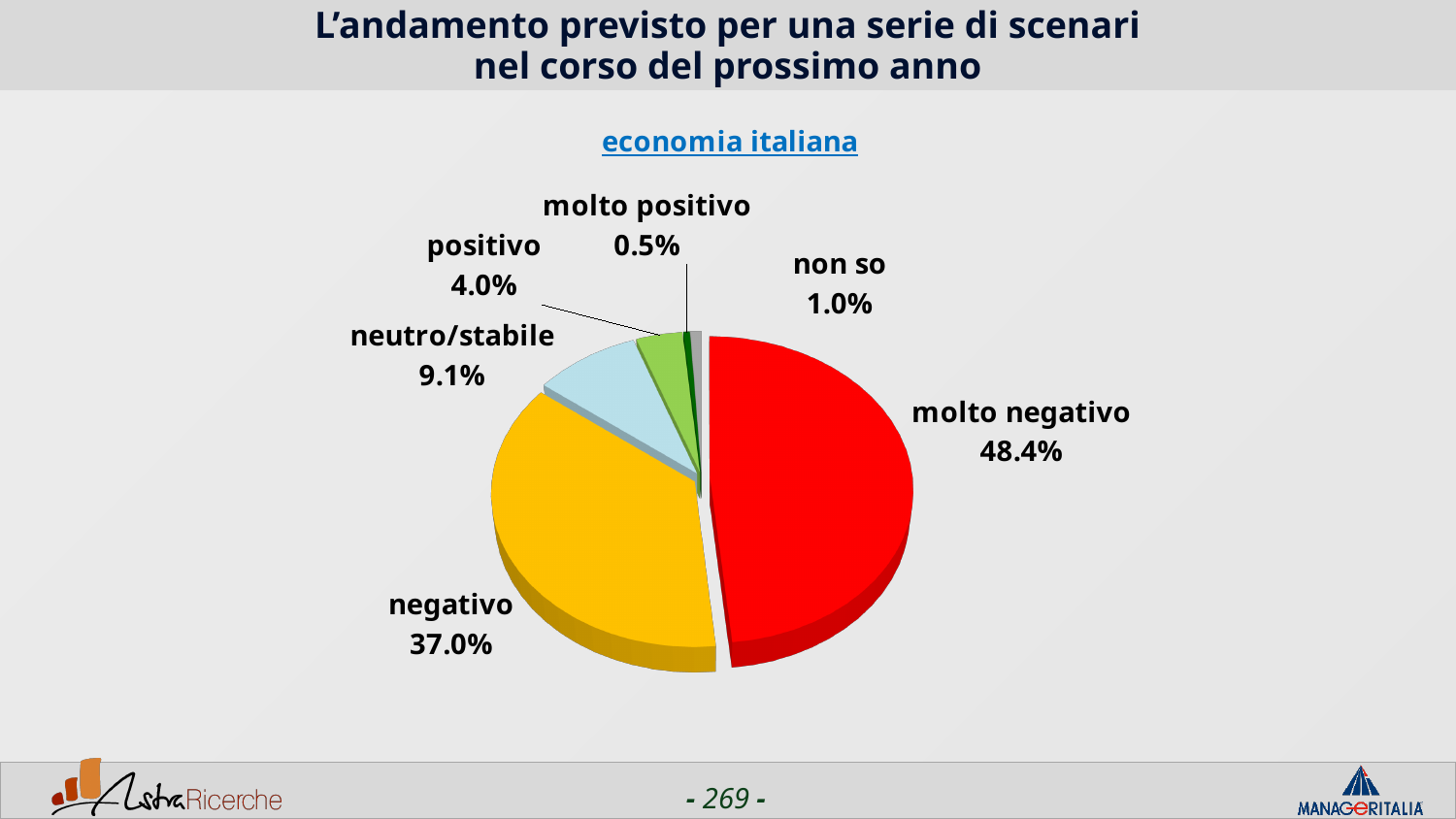
What is the value shown for 'positivo'? 4.0% Which category has the largest slice of the pie? molto negativo What kind of chart is shown on the slide? pie chart What is the value shown for 'non so'? 1.0% What is the difference between the 'molto negativo' and 'negativo' shares? 11.4% What share of the pie is labelled 'molto negativo'? 48.4% What is the value shown for 'neutro/stabile'? 9.1% Which category has the smallest slice of the pie? molto positivo What is the subtitle shown above the pie chart? economia italiana How many categories are shown in the pie chart? 6 Which is larger, the share for 'neutro/stabile' or the share for 'positivo'? neutro/stabile What is the value shown for 'negativo'? 37.0%